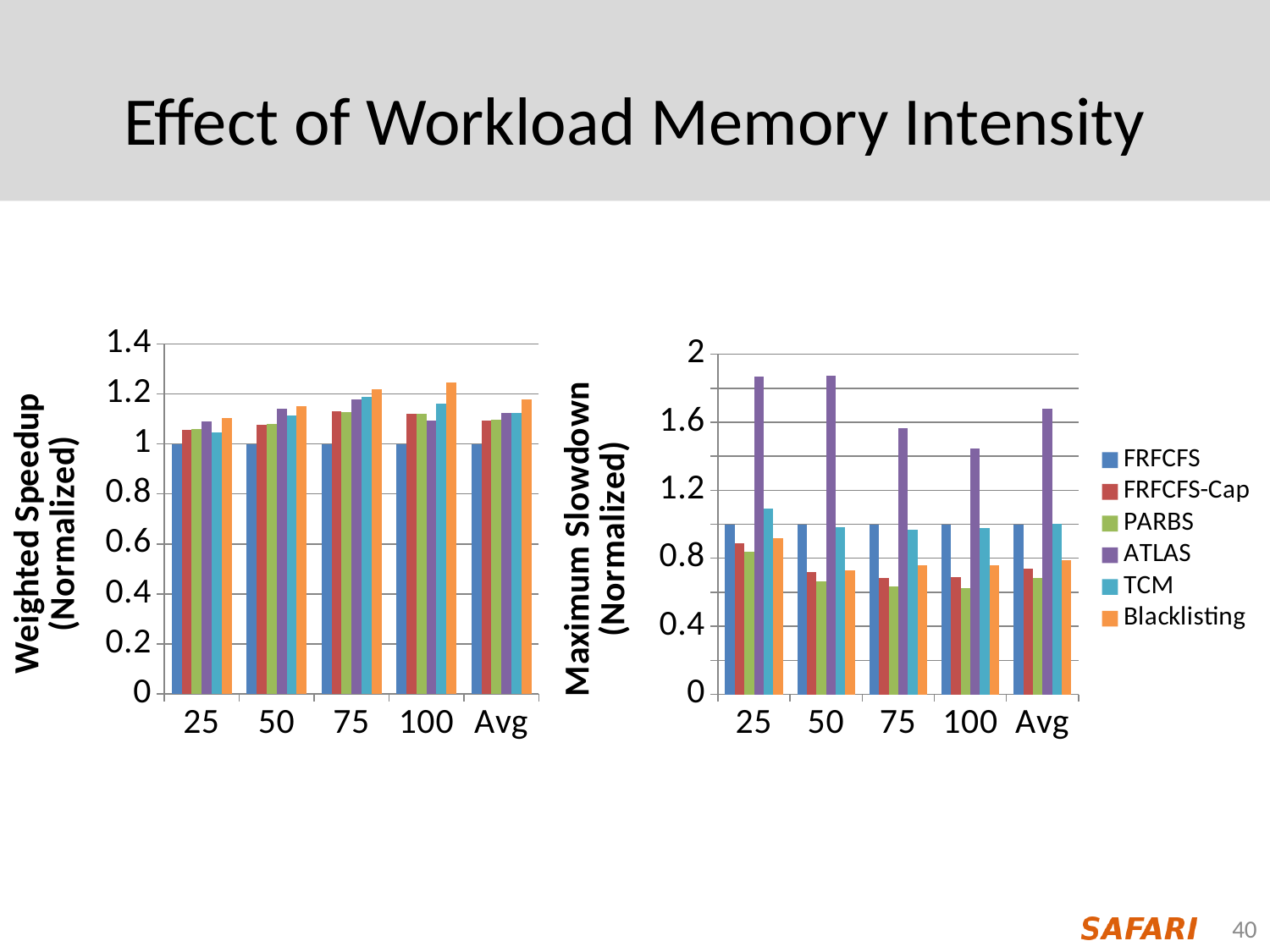
In the right chart, Maximum Slowdown (Normalized), which series has the lowest value at 75? PARBS What kind of chart is the left chart, Weighted Speedup (Normalized)? bar chart In the right chart, Maximum Slowdown (Normalized), which series has the highest value at 25? ATLAS How many series does the legend list for the charts on this slide? 6 In the left chart, Weighted Speedup (Normalized), which series has the highest value at 100? Blacklisting In the right chart, Maximum Slowdown (Normalized), does the ATLAS value rise or fall from 25 to 100? fall In the right chart, Maximum Slowdown (Normalized), which is larger at 50: ATLAS or TCM? ATLAS How many categories are shown on the x axis of the right chart, Maximum Slowdown (Normalized)? 5 In the right chart, Maximum Slowdown (Normalized), is the value for PARBS at 50 greater or less than 0.8? less In the left chart, Weighted Speedup (Normalized), what is the value for FRFCFS at 25? 1 In the left chart, Weighted Speedup (Normalized), which is larger at 25: FRFCFS or Blacklisting? Blacklisting In the right chart, Maximum Slowdown (Normalized), is the value for ATLAS at 25 greater or less than 1.6? greater